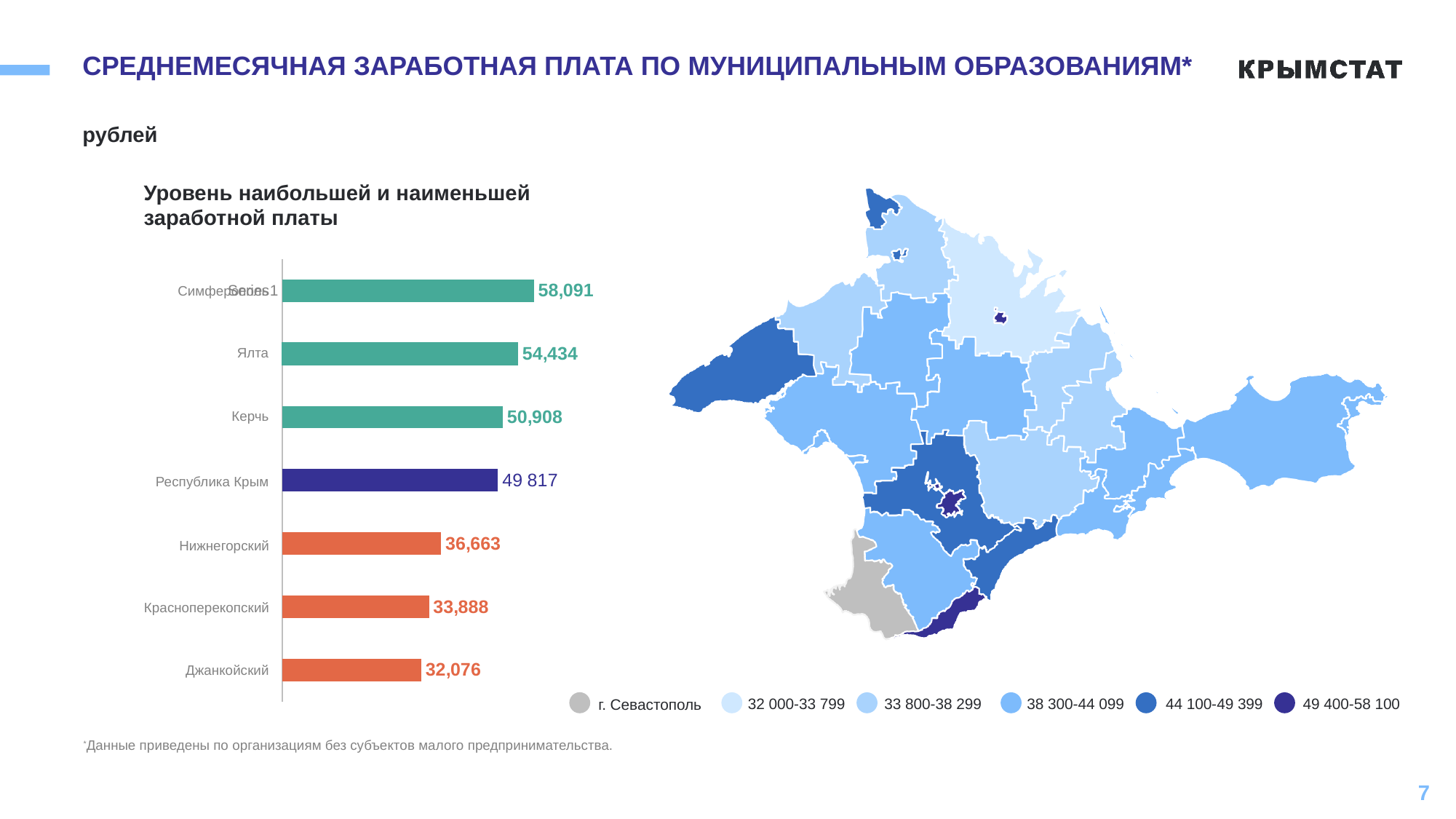
What is the difference between the values for Нижнегорский and Джанкойский in the bar chart? 4,587 What is the value for Республика Крым in the bar chart? 49 817 Which category has the lowest value in the bar chart? Джанкойский What is the value for Керчь in the bar chart? 50,908 What is the difference between the values for Ялта and Керчь in the bar chart? 3,526 What is the value for Ялта in the bar chart? 54,434 What type of chart is used to show the highest and lowest wage levels? Bar chart What is the value for Джанкойский in the bar chart? 32,076 How many categories are shown in the bar chart? 7 What is the value for Нижнегорский in the bar chart? 36,663 What is the value for Красноперекопский in the bar chart? 33,888 Which is larger in the bar chart, the value for Керчь or the value for Республика Крым? Керчь